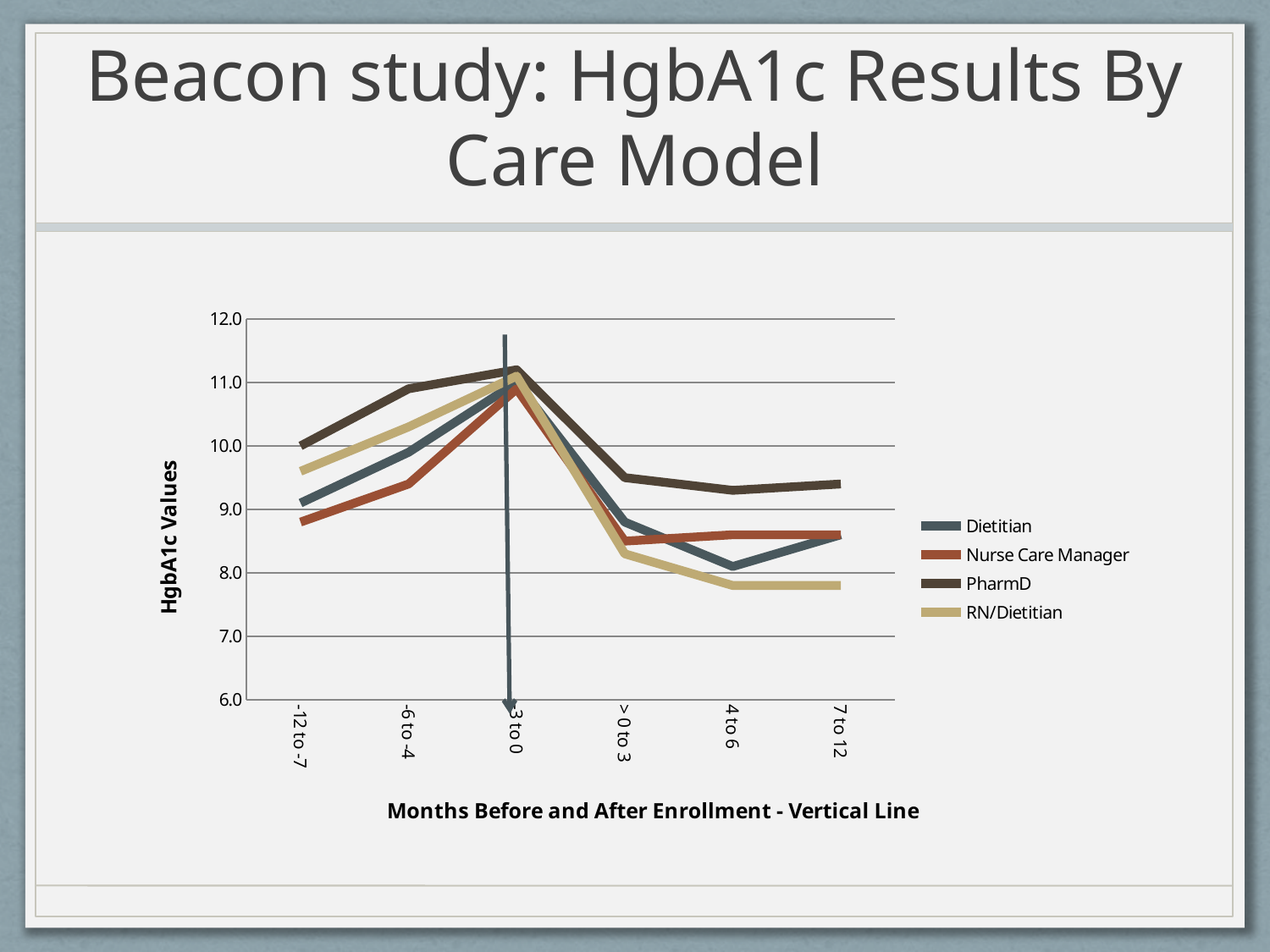
What is the title of the y axis? HgbA1c Values Which care model has the lowest HgbA1c value at 7 to 12 months? RN/Dietitian Does the Dietitian line rise or fall from -12 to -7 months to -3 to 0 months? rises What kind of chart is shown on the slide? line chart Is the PharmD value at > 0 to 3 months greater or less than 10.0? less At 7 to 12 months, which is larger: the PharmD value or the Nurse Care Manager value? PharmD How many series does the legend list? 4 Is the RN/Dietitian value at -12 to -7 months greater or less than 10.0? less Is the Nurse Care Manager value at -6 to -4 months greater or less than 9.0? greater Which care model has the highest HgbA1c value at 4 to 6 months? PharmD How many time-period categories are shown on the x axis? 6 Which care model has the highest HgbA1c value at -12 to -7 months? PharmD